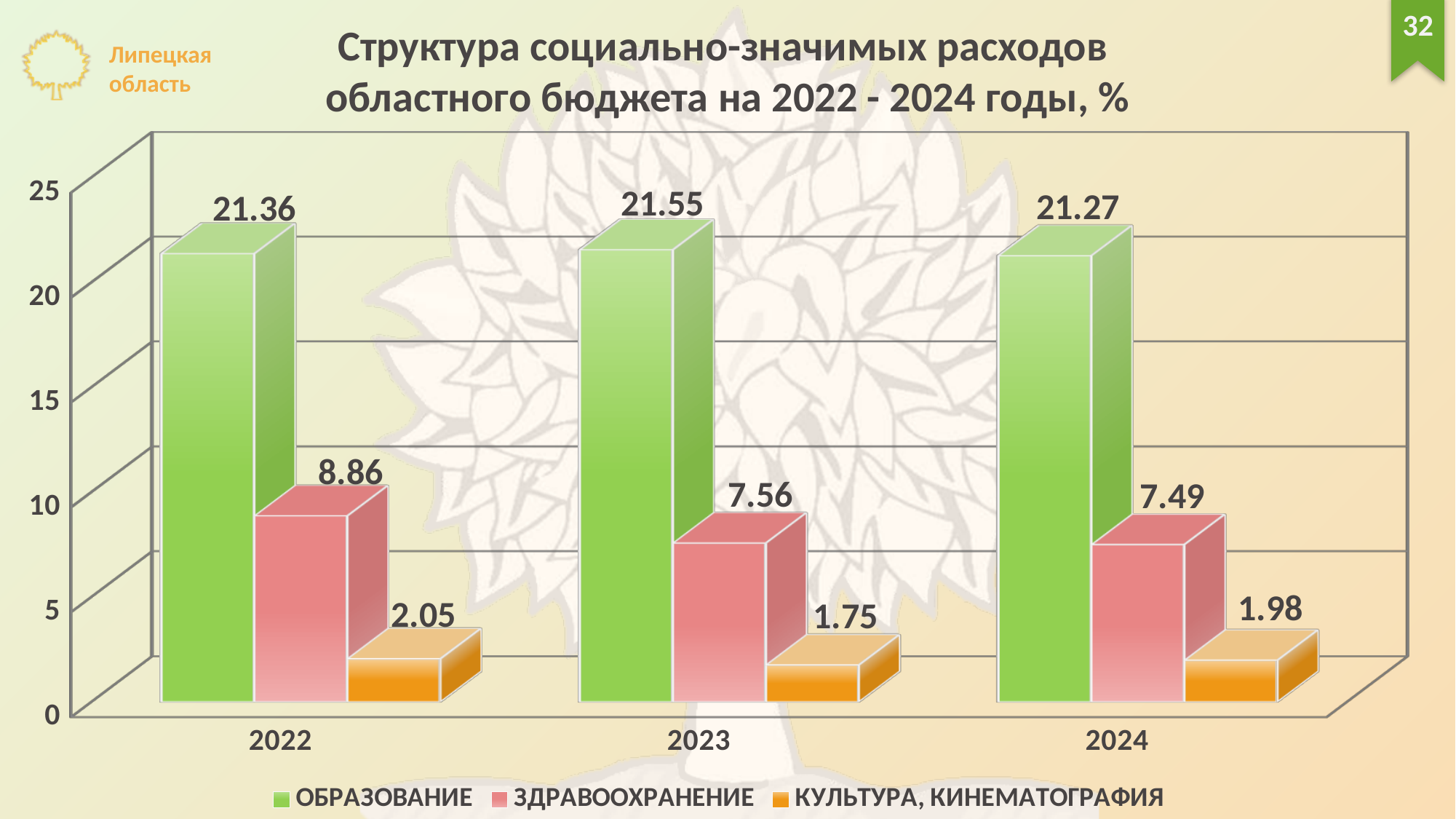
In which year is the value for ОБРАЗОВАНИЕ the highest? 2023 How many series does the legend list? 3 Is the value for ЗДРАВООХРАНЕНИЕ in 2022 greater or less than 10? less What is the value for КУЛЬТУРА, КИНЕМАТОГРАФИЯ in 2024? 1.98 In which year is the value for КУЛЬТУРА, КИНЕМАТОГРАФИЯ the lowest? 2023 What kind of chart is shown on the slide? bar chart Which colour represents ОБРАЗОВАНИЕ in the legend? green Which is larger: the ЗДРАВООХРАНЕНИЕ value in 2024 or in 2022? 2022 What is the value for ЗДРАВООХРАНЕНИЕ in 2023? 7.56 What is the value for ОБРАЗОВАНИЕ in 2022? 21.36 How many years are shown on the x axis? 3 What is the difference between the ЗДРАВООХРАНЕНИЕ values for 2022 and 2023? 1.3